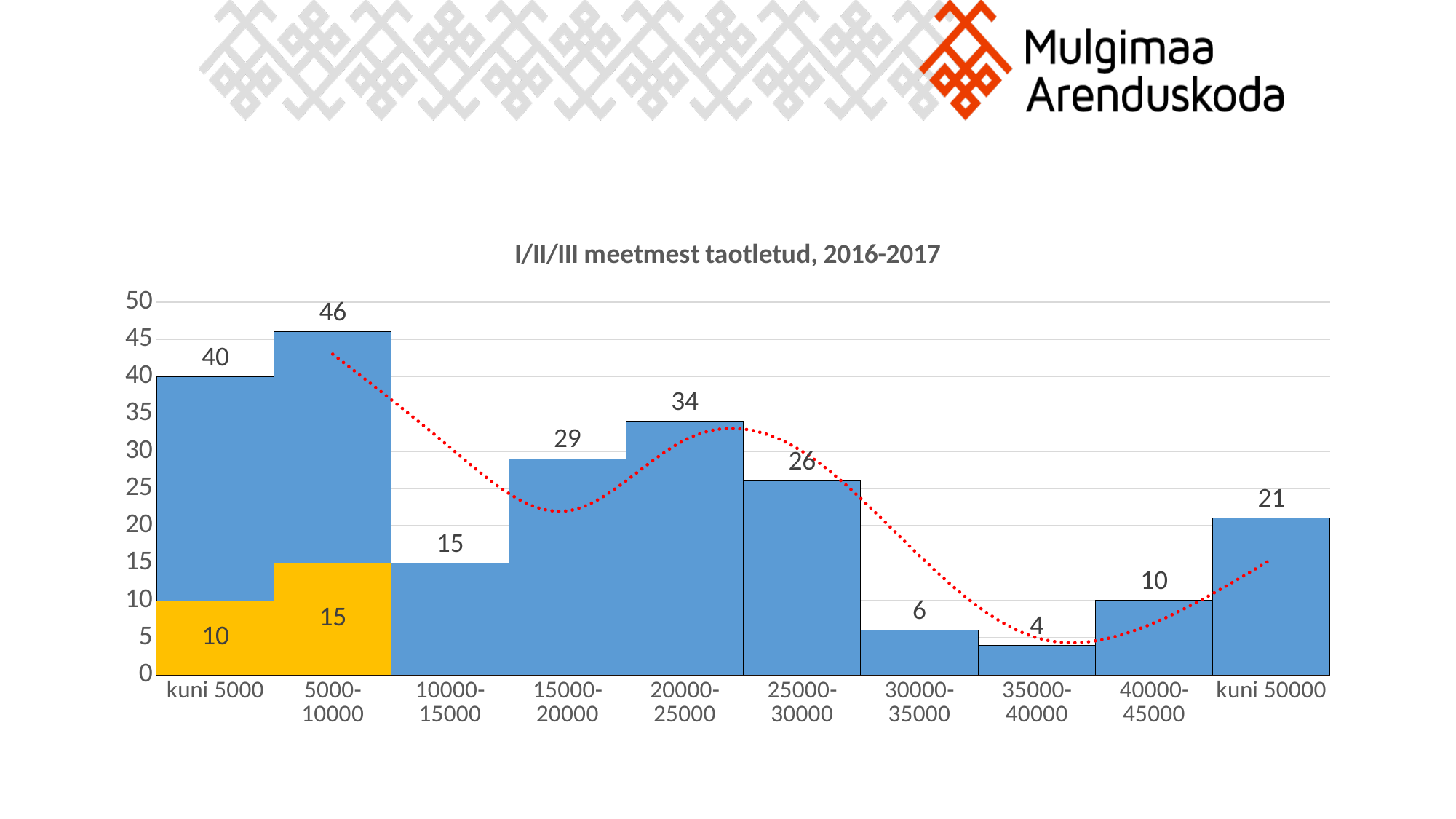
What is the difference between the blue bar values for 5000-10000 and kuni 5000? 6 Which is larger, the blue bar for 15000-20000 or the blue bar for 25000-30000? 15000-20000 What kind of chart is shown on the slide? bar chart What is the value of the blue bar for the 35000-40000 category? 4 Which category has the lowest blue bar? 35000-40000 What is the value of the orange bar for the kuni 5000 category? 10 How many categories are shown on the x axis? 10 Which category has the highest blue bar? 5000-10000 What is the value of the blue bar for the 5000-10000 category? 46 What colour are the bars for the kuni 5000 and 5000-10000 categories that are drawn in front of the blue bars? orange What is the value of the blue bar for the 20000-25000 category? 34 What is the title of the chart? I/II/III meetmest taotletud, 2016-2017